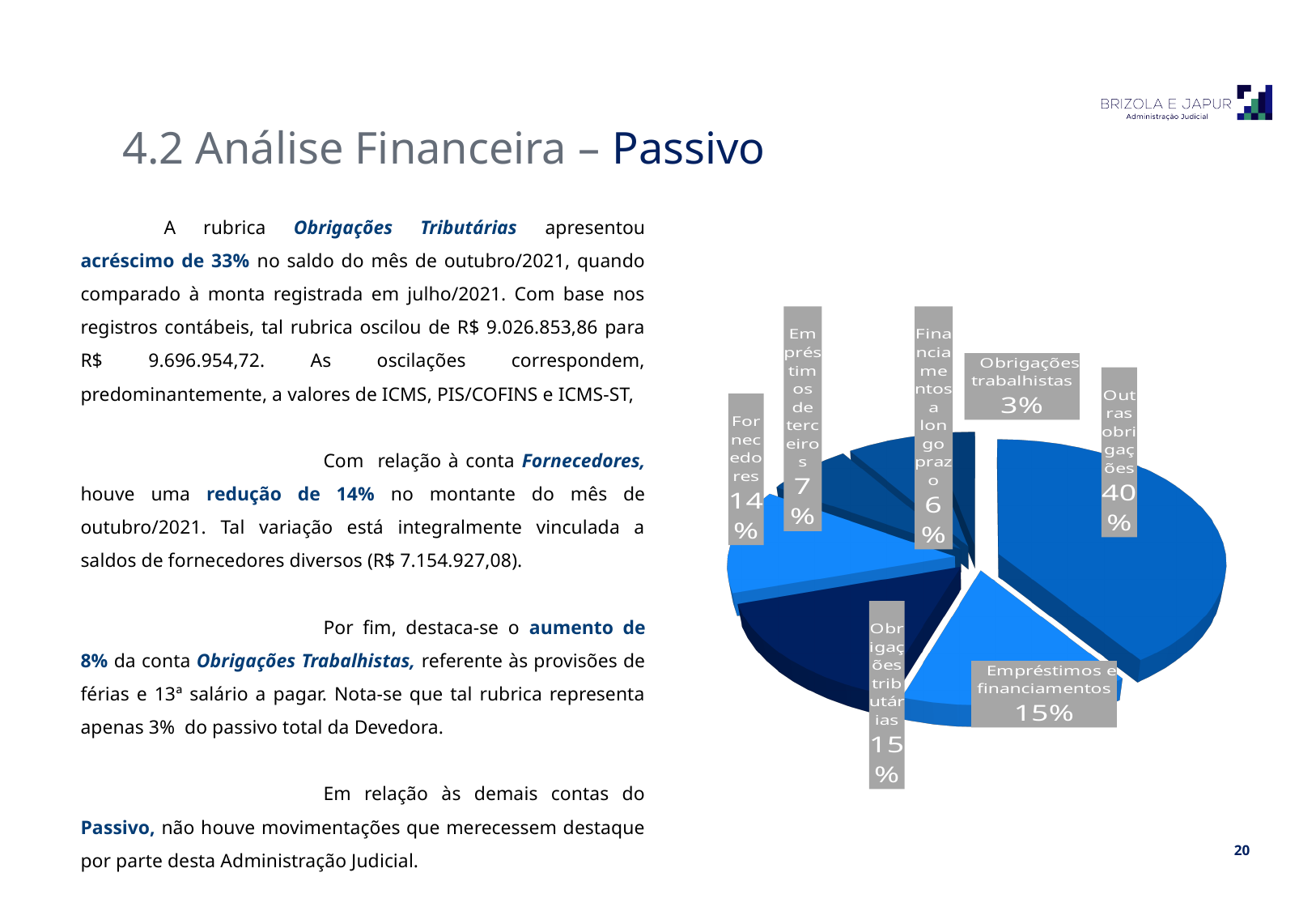
What is the value shown for Empréstimos e financiamentos? 15% Which category has the largest slice of the pie? Outras obrigações What share of the pie does Outras obrigações represent? 40% What is the value shown for Financiamentos a longo prazo? 6% What is the difference between the shares of Outras obrigações and Fornecedores? 26% What type of chart is shown on the slide? Pie chart What is the value shown for Obrigações trabalhistas? 3% Which is larger, the share for Empréstimos de terceiros or the share for Financiamentos a longo prazo? Empréstimos de terceiros Which category has the smallest slice of the pie? Obrigações trabalhistas How many slices does the pie chart have? 7 What is the difference between the shares of Obrigações tributárias and Obrigações trabalhistas? 12% What is the value shown for Fornecedores? 14%